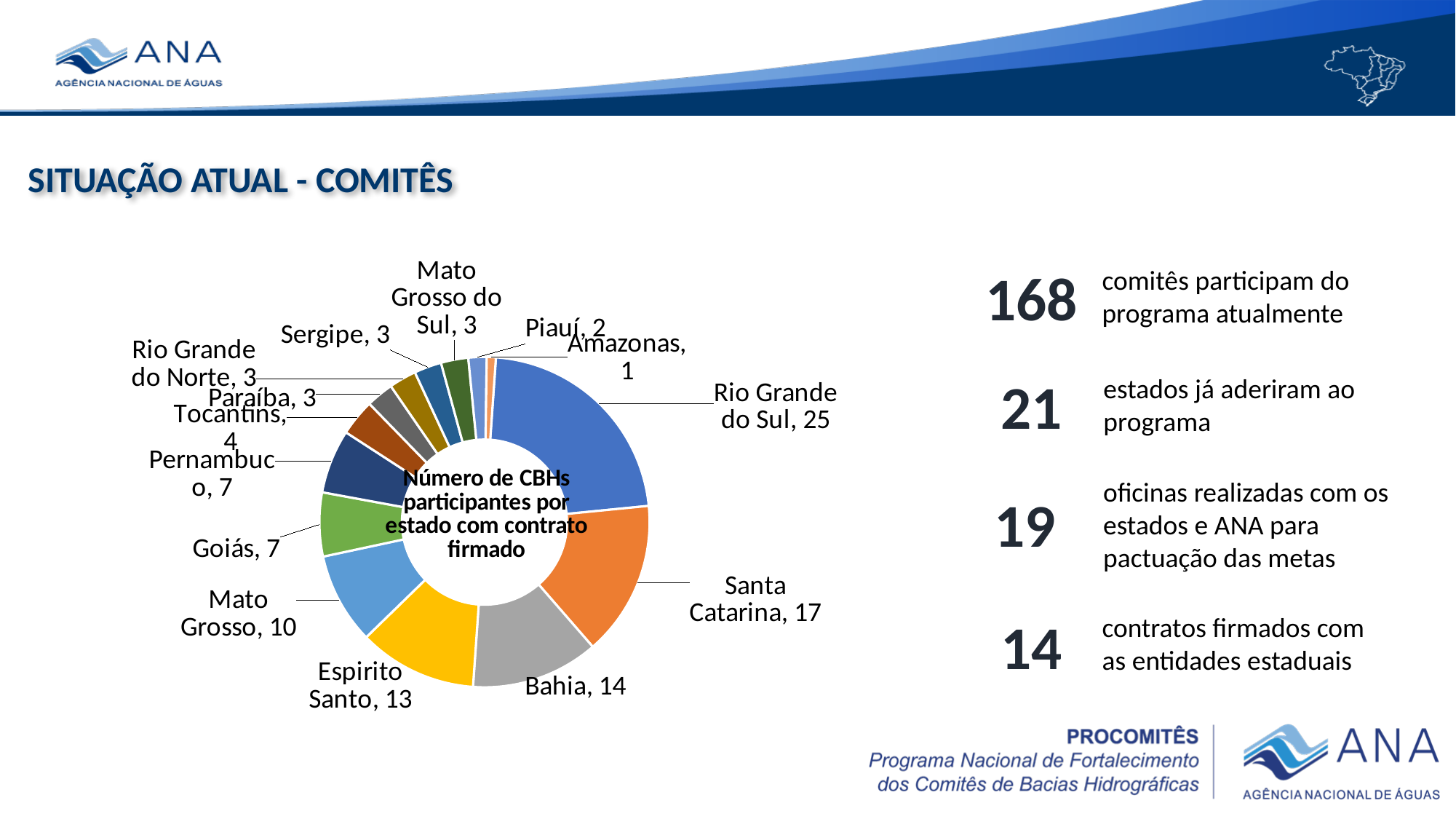
What is the difference between the values for Rio Grande do Sul and Bahia? 11 Which is larger, the value for Mato Grosso or the value for Goiás? Mato Grosso How many CBHs does the chart show for Rio Grande do Sul? 25 What is the title of the chart? Número de CBHs participantes por estado com contrato firmado What is the value shown for Tocantins? 4 Which state has the largest slice in the chart? Rio Grande do Sul How many states (slices) are shown in the chart? 14 What is the value shown for Espirito Santo? 13 What is the value shown for Santa Catarina? 17 Which state has the smallest slice in the chart? Amazonas What kind of chart is shown on the slide? doughnut (pie) chart What is the difference between the values for Santa Catarina and Espirito Santo? 4